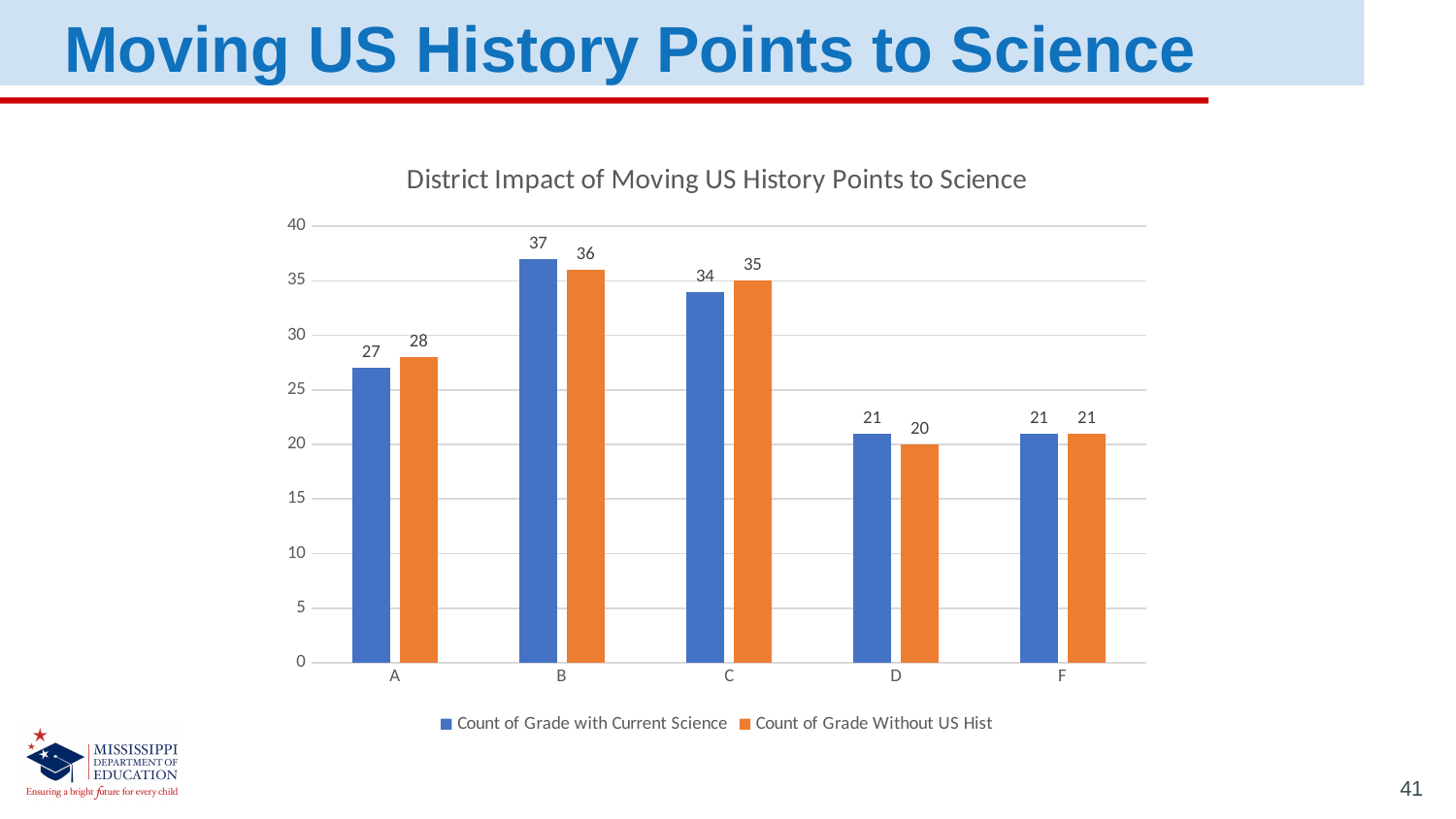
What kind of chart is shown on the slide? Bar chart For grade C, which is larger: Count of Grade with Current Science or Count of Grade Without US Hist? Count of Grade Without US Hist Is the Count of Grade with Current Science for grade A greater or less than 25? greater Which grade has the highest Count of Grade with Current Science? B What is the difference between the Count of Grade Without US Hist and the Count of Grade with Current Science for grade A? 1 What is the Count of Grade Without US Hist for grade D? 20 What is the Count of Grade Without US Hist for grade C? 35 What is the Count of Grade with Current Science for grade B? 37 Which grade has the lowest Count of Grade Without US Hist? D What is the title of the chart? District Impact of Moving US History Points to Science How many series does the legend list? 2 How many grade categories are shown on the x axis? 5